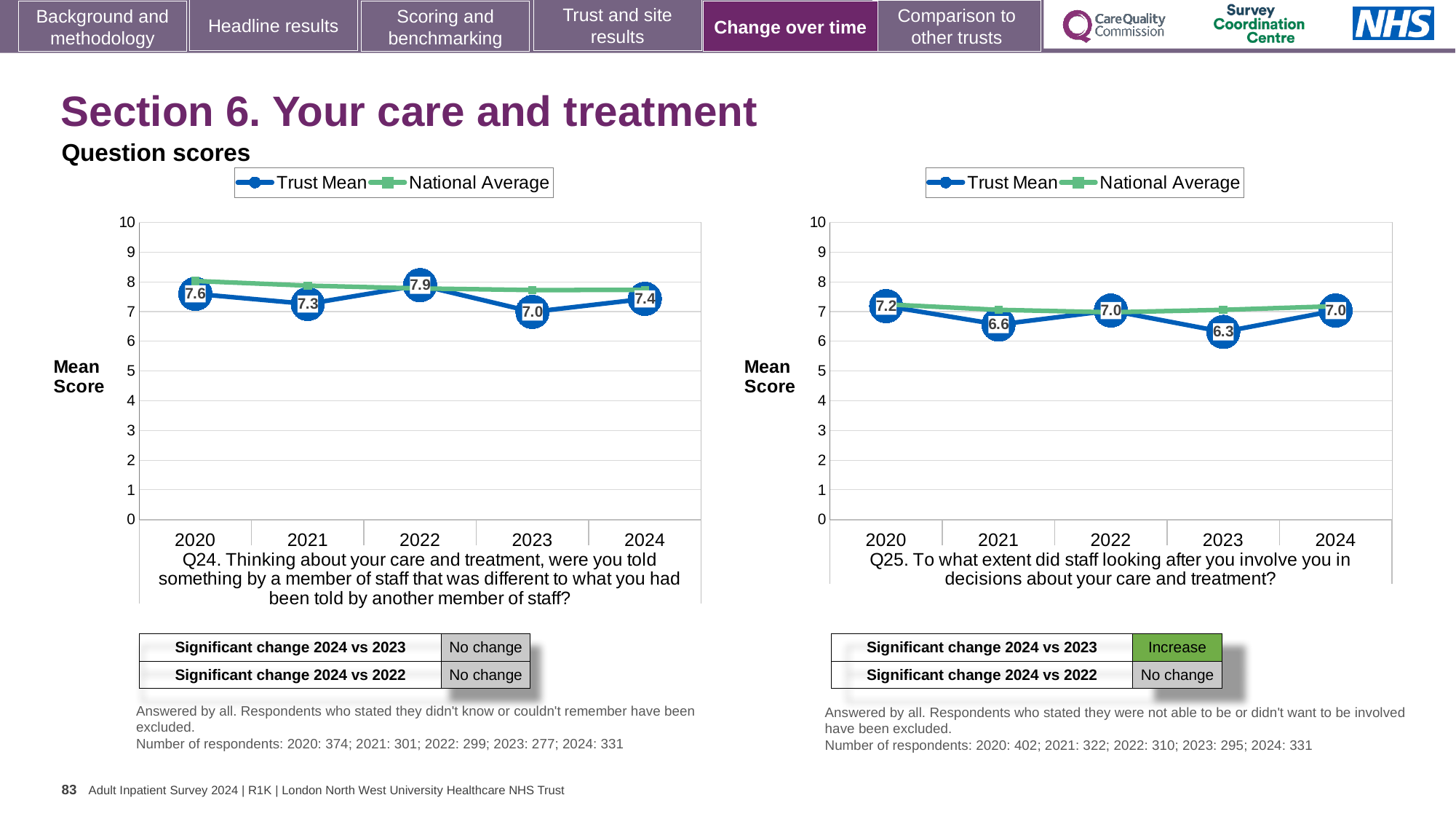
In the Q24 chart on the left, what is the difference between the Trust Mean scores for 2022 and 2023? 0.9 How many series does the legend of the Q24 chart on the left list? 2 In the Q24 chart on the left, what is the Trust Mean score for 2023? 7.0 In the Q24 chart on the left, which year has the highest Trust Mean score? 2022 How many years are plotted on the x axis of the Q25 chart on the right? 5 In the Q25 chart on the right, which year has the lowest Trust Mean score? 2023 In the Q25 chart on the right, which is larger, the Trust Mean for 2020 or the Trust Mean for 2023? 2020 What type of chart is the Q24 chart on the left? Line chart In the Q25 chart on the right, what is the Trust Mean score for 2021? 6.6 In the Q24 chart on the left, is the National Average for 2020 greater or less than 7? greater In the Q24 chart on the left, what is the Trust Mean score for 2022? 7.9 In the Q25 chart on the right, what is the difference between the Trust Mean scores for 2024 and 2023? 0.7